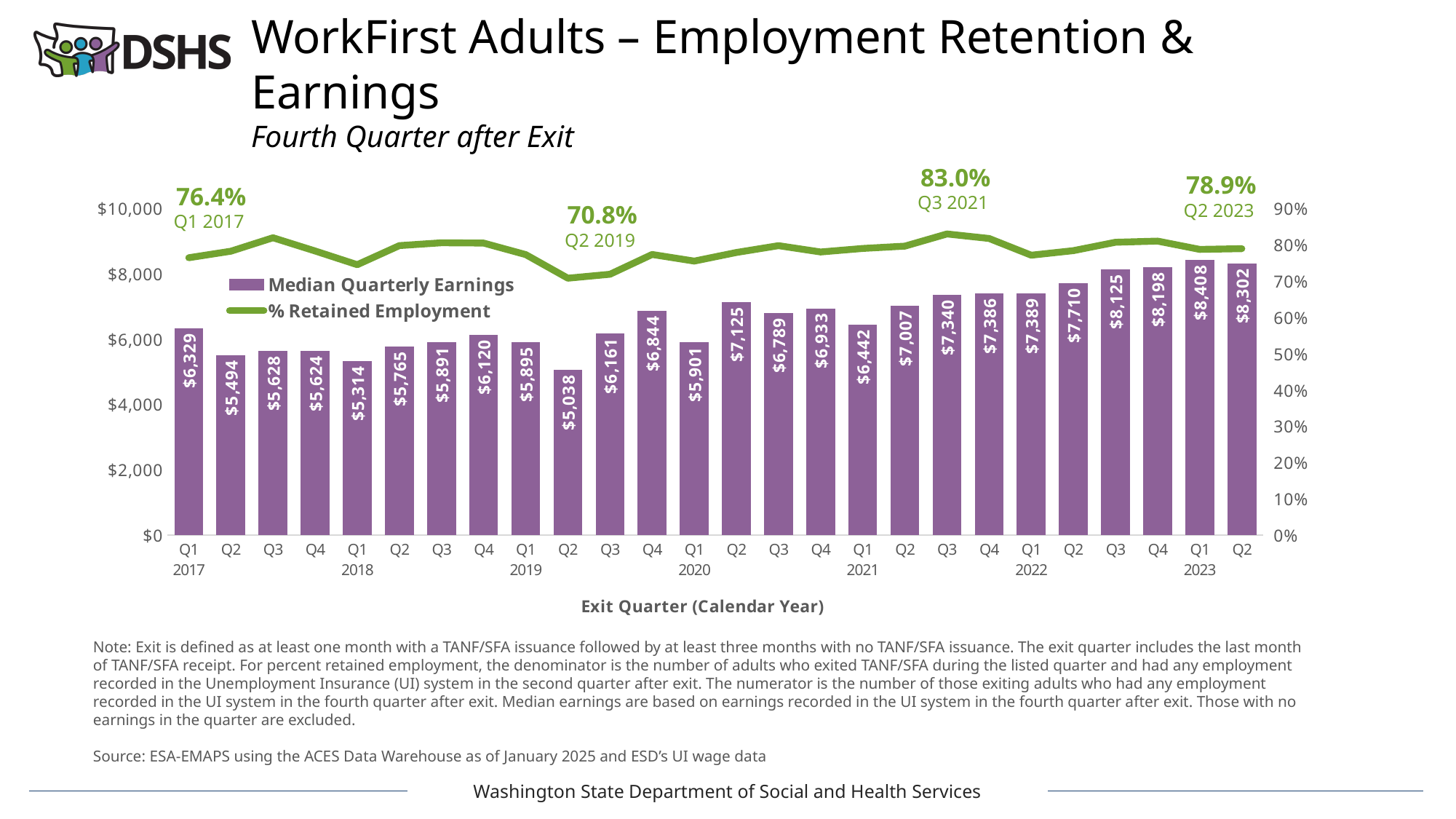
What is the difference between Median Quarterly Earnings for Q1 2023 and Q2 2023? $106 What is the % Retained Employment for Q3 2021? 83.0% How many exit quarters are shown on the x axis? 26 How many series does the legend list? 2 Which exit quarter has the highest Median Quarterly Earnings? Q1 2023 Is the % Retained Employment for Q3 2019 greater or less than 80%? less What is the Median Quarterly Earnings value for Q1 2017? $6,329 What is the % Retained Employment for Q2 2019? 70.8% What kind of chart is shown on the slide? Combination bar and line chart Which has higher Median Quarterly Earnings, Q4 2020 or Q1 2021? Q4 2020 Which exit quarter has the lowest Median Quarterly Earnings? Q2 2019 What is the Median Quarterly Earnings value for Q2 2023? $8,302